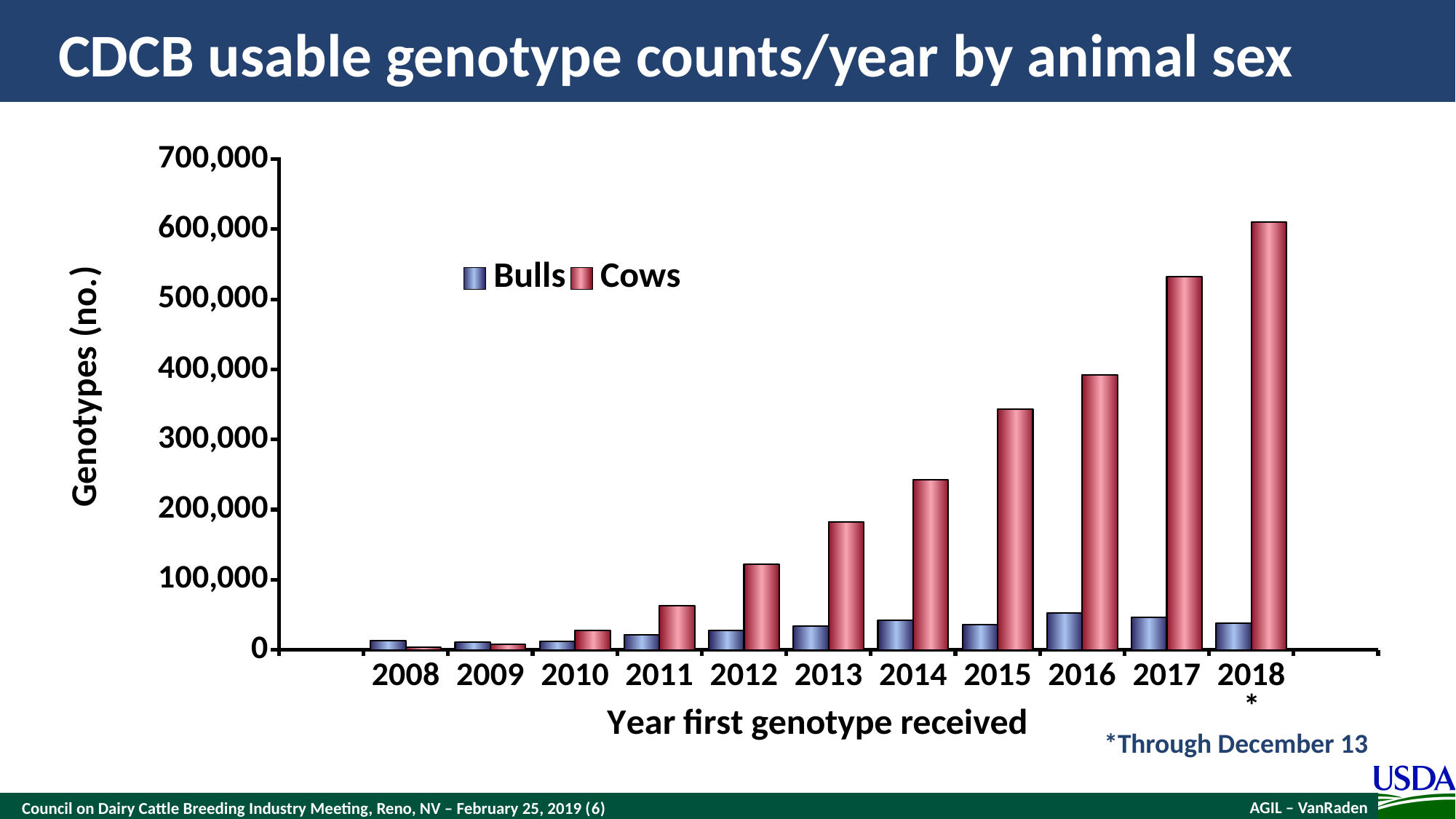
In 2012, which is larger, the Bulls value or the Cows value? Cows Is the Cows value for 2017 greater or less than 500,000? greater In which year is the Cows value highest? 2018 Is the Cows value for 2015 greater or less than 300,000? greater How many series does the legend list? 2 What kind of chart is shown on the slide? bar chart In 2008, which is larger, the Bulls value or the Cows value? Bulls Do the Cows values rise or fall from 2008 to 2018? rise Is the Cows value for 2018 greater or less than 500,000? greater How many years are shown on the x axis? 11 In which year is the Cows value lowest? 2008